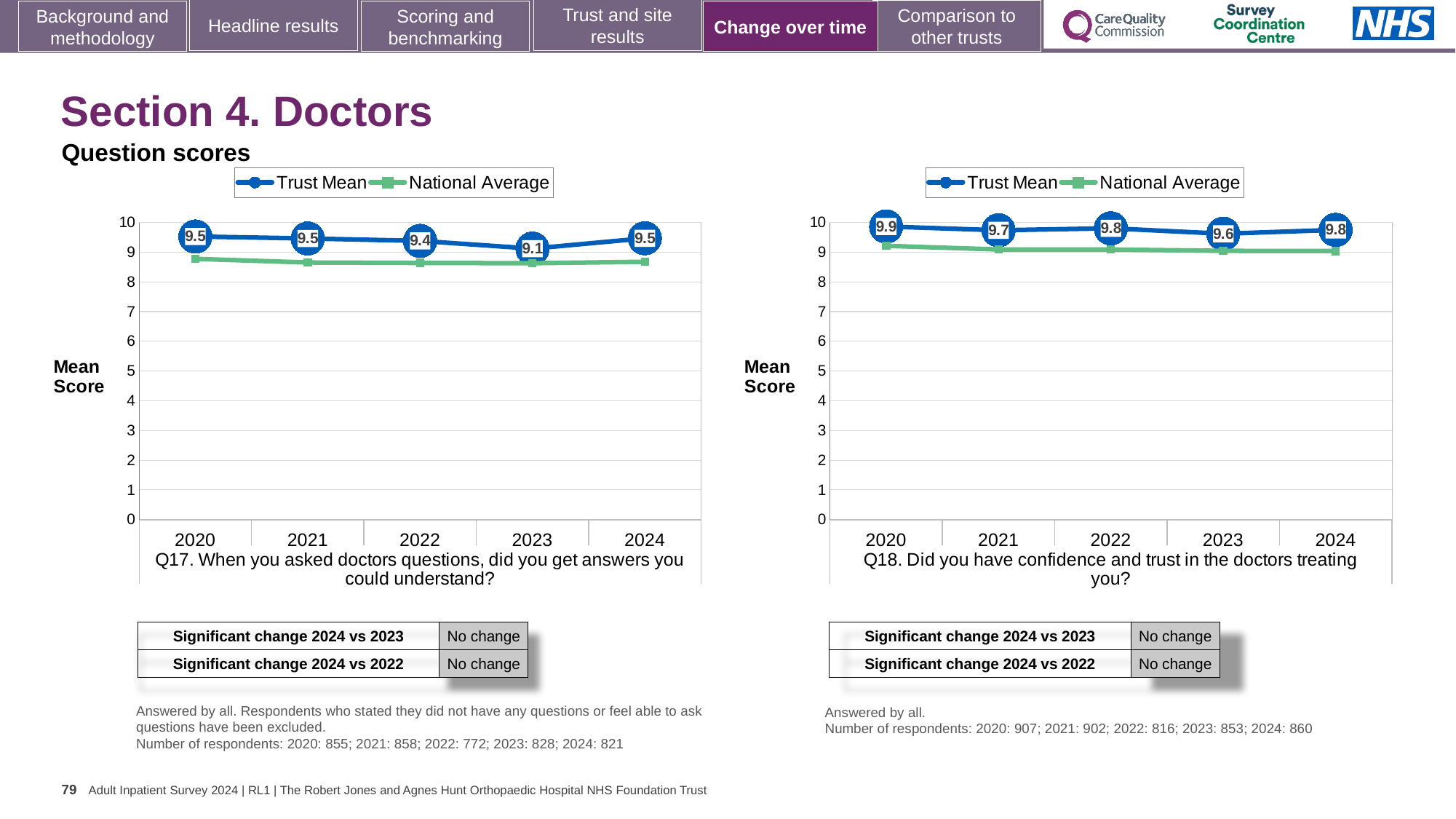
In the Q17 chart, which year has the lowest Trust Mean score? 2023 In the Q18 chart, which is larger, the Trust Mean for 2021 or for 2022? 2022 In the Q17 chart, what is the Trust Mean score for 2023? 9.1 In the Q18 chart, what is the Trust Mean score for 2020? 9.9 In the Q17 chart, what is the difference between the Trust Mean scores for 2024 and 2023? 0.4 How many years are plotted on the x axis of the Q18 chart? 5 In the Q17 chart, is the National Average value for 2021 greater or less than 9? less In the Q18 chart, what is the difference between the Trust Mean scores for 2020 and 2023? 0.3 In the Q18 chart, which year has the highest Trust Mean score? 2020 What type of chart is used for Q17? Line chart In the Q18 chart, which year has the lowest Trust Mean score? 2023 How many series does the legend of the Q17 chart list? 2